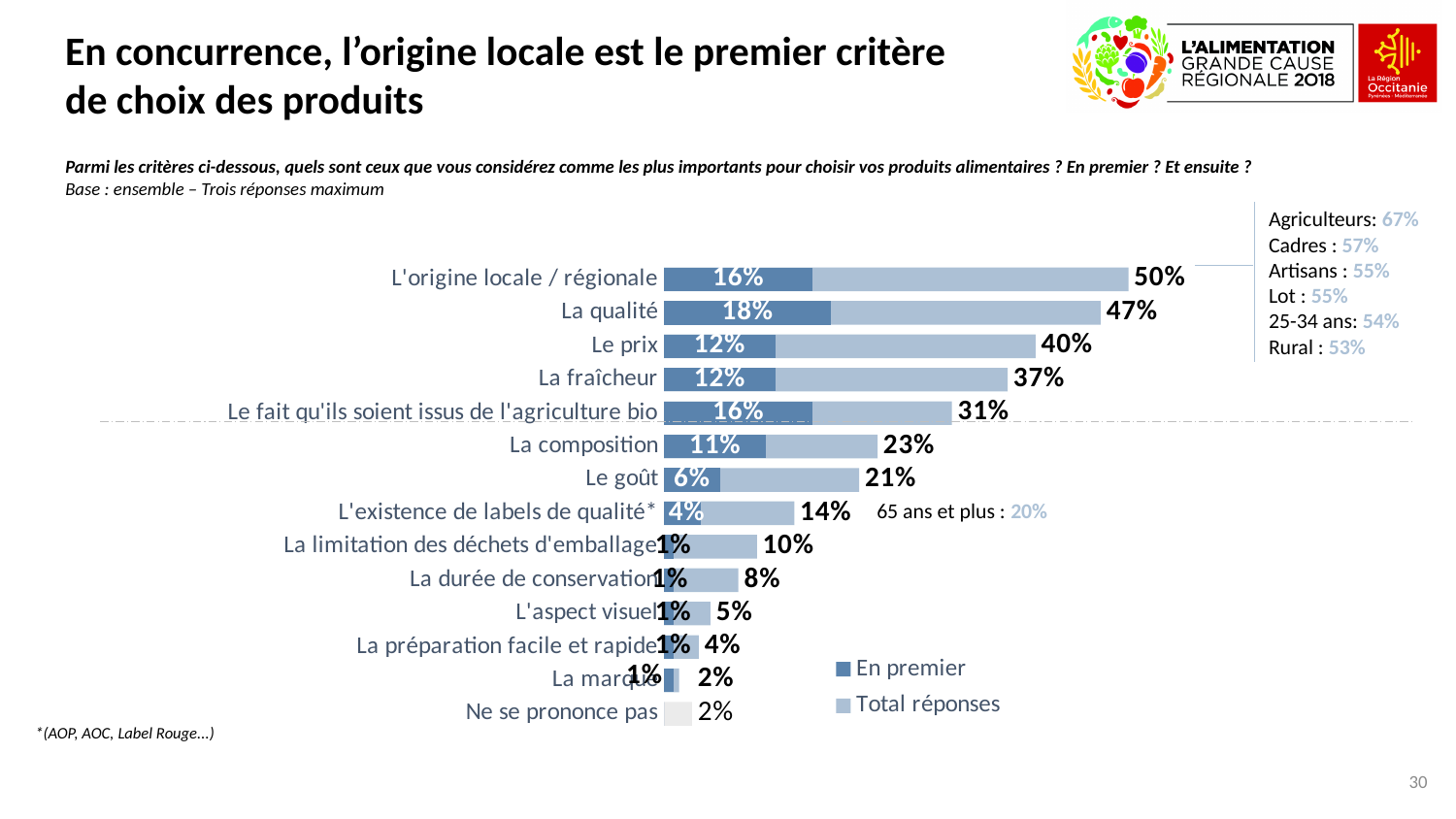
Which category has the highest 'En premier' value? La qualité What kind of chart is shown on the slide? Bar chart What is the 'Total réponses' value for 'L'origine locale / régionale'? 50% How many series does the legend list? 2 What is the difference between the 'Total réponses' values for 'La qualité' and 'Le prix'? 7% What is the 'En premier' value for 'La qualité'? 18% Which has a larger 'Total réponses' value, 'La fraîcheur' or 'La composition'? La fraîcheur What is the 'En premier' value for 'Le goût'? 6% Which category has the highest 'Total réponses' value? L'origine locale / régionale What is the 'Total réponses' value for 'Le prix'? 40% How many categories are shown in the chart? 14 What are the two series named in the legend? En premier and Total réponses